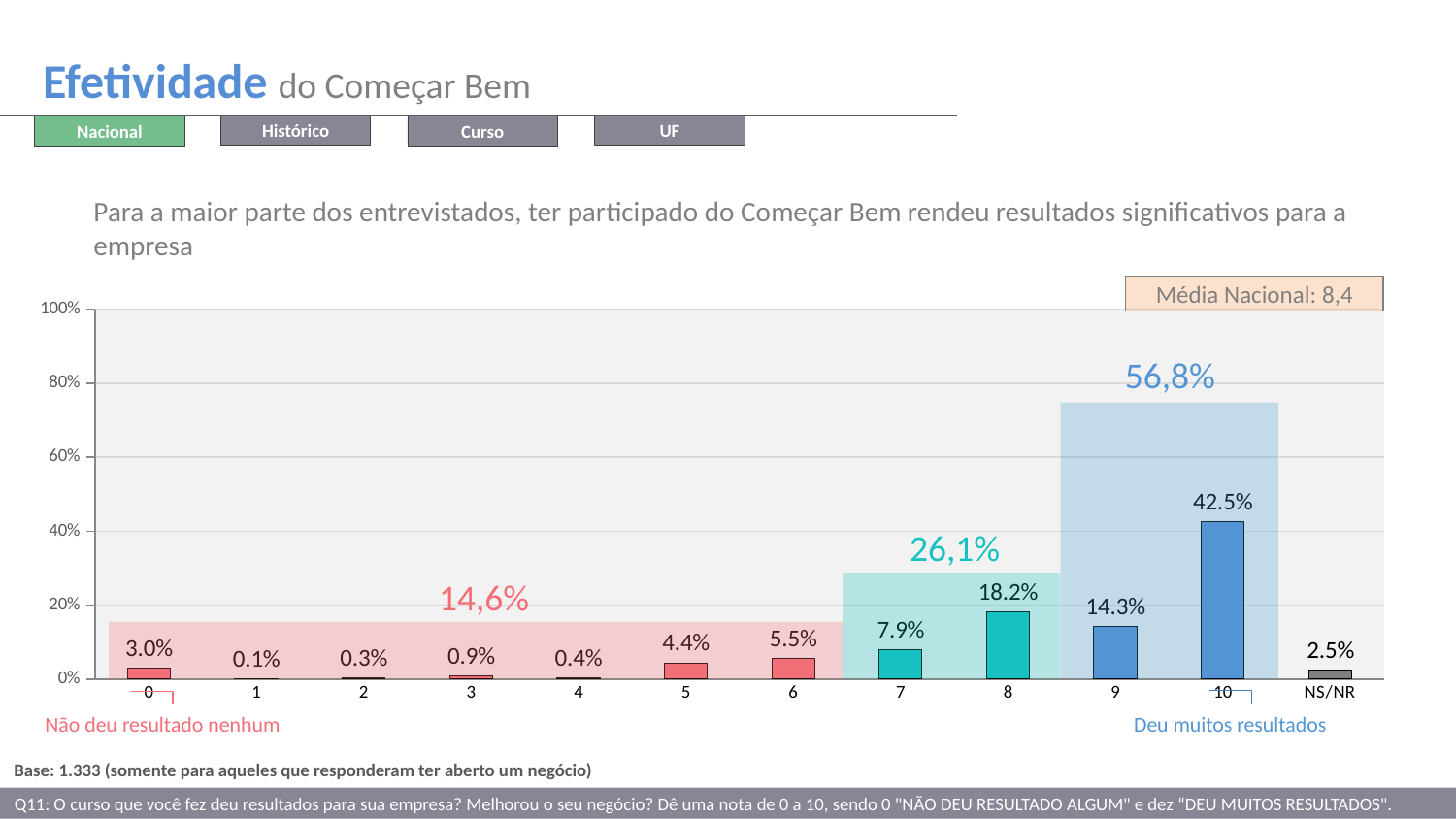
What national average (Média Nacional) is shown on the chart? 8,4 What is the value for category 10? 42.5% How many categories are shown on the x axis? 12 Which category has the highest value? 10 What is the value for category 8? 18.2% What is the combined share shown for the group of categories 9 and 10? 56,8% What is the difference between the values for categories 10 and 9? 28.2% Is the value for category 10 greater or less than 40%? greater What kind of chart is shown on the slide? bar chart Which is larger, the value for category 7 or the value for category 8? 8 Which category has the lowest value? 1 What is the value for the NS/NR category? 2.5%